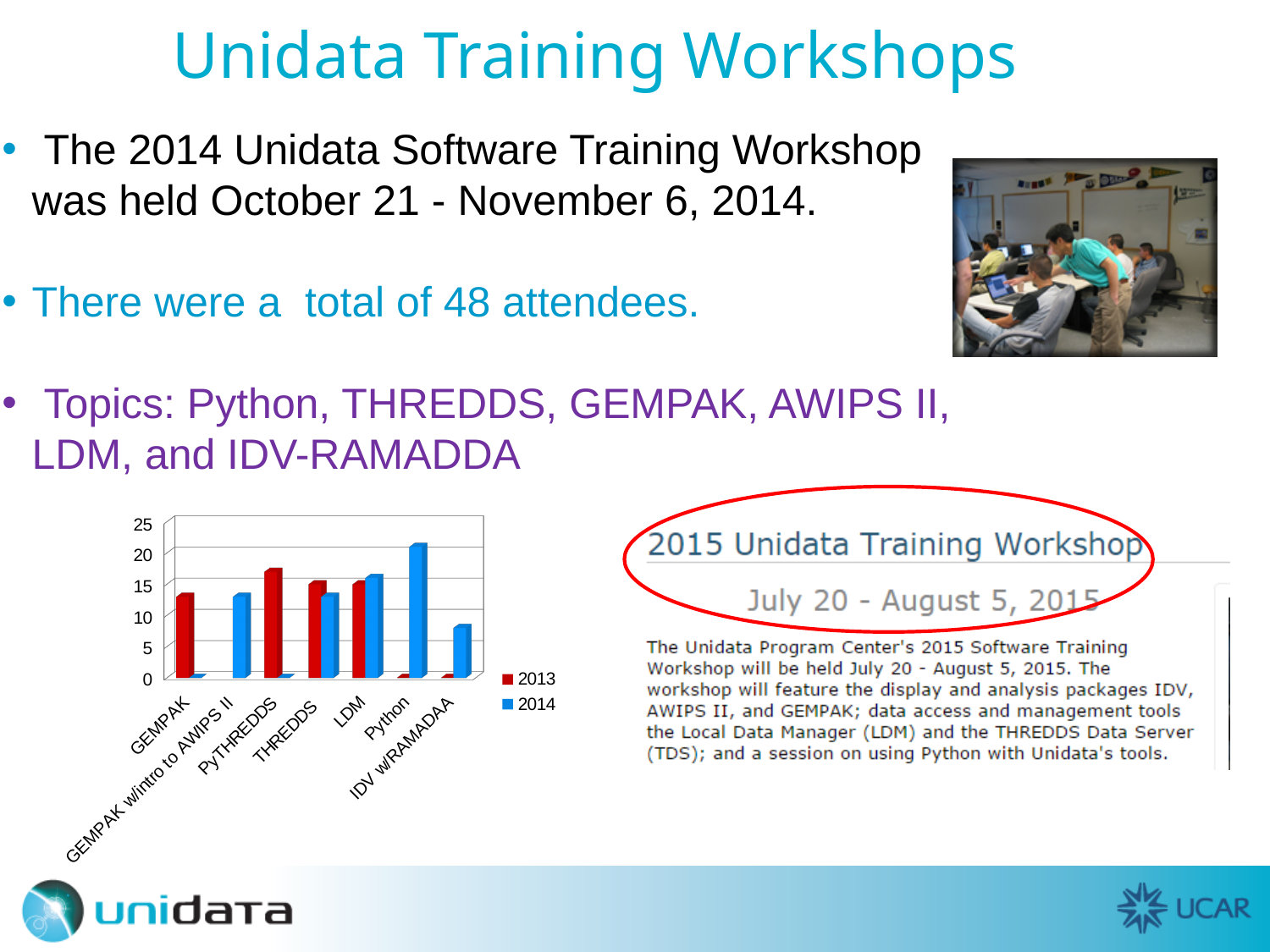
Is the 2013 value for GEMPAK greater or less than 10? greater Is the 2014 value for Python greater or less than 15? greater Which is larger: the 2013 value for PyTHREDDS or the 2013 value for GEMPAK? PyTHREDDS How many series does the legend of the bar chart list? 2 Which is larger: the 2014 value for Python or the 2014 value for IDV w/RAMADAA? Python Is the 2013 value for PyTHREDDS greater or less than 15? greater Which category has the highest value for the 2013 series? PyTHREDDS Which colour represents the 2014 series in the bar chart? blue What kind of chart is shown on the slide? bar chart Which category has the highest value for the 2014 series? Python How many categories are shown on the x axis of the bar chart? 7